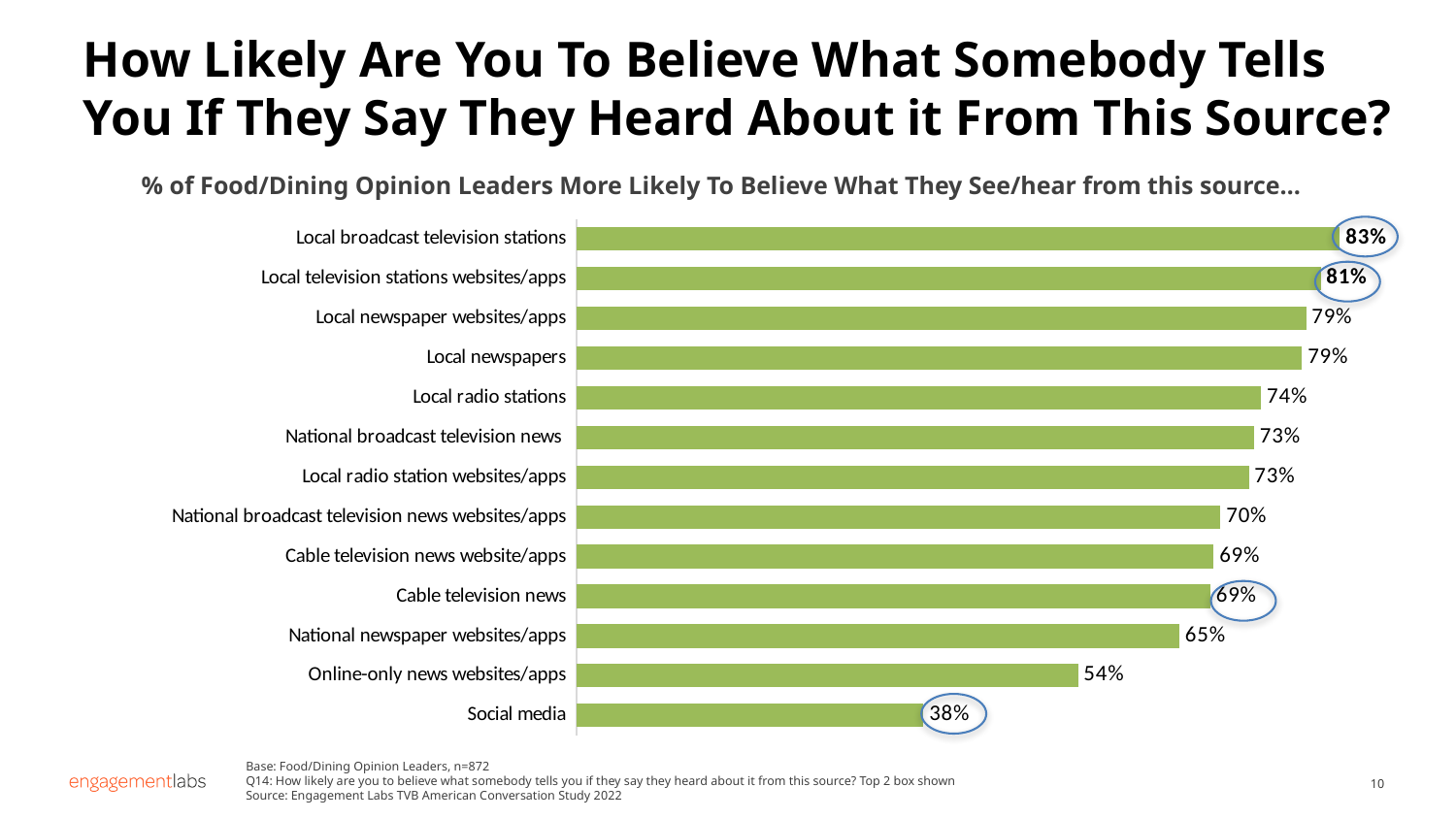
What is the value shown for Social media? 38% What colour are the bars on the chart? Green What kind of chart is shown on the slide? Bar chart Which has a larger value: Local newspapers or Cable television news? Local newspapers Which source has the highest percentage on the chart? Local broadcast television stations What is the difference between the values for Local broadcast television stations and Social media? 45 percentage points What is the value shown for Online-only news websites/apps? 54% What is the value shown for Local radio stations? 74% How many sources are shown on the chart? 13 Which source has the lowest percentage on the chart? Social media What is the difference between the values for Local television stations websites/apps and National newspaper websites/apps? 16 percentage points What percentage of Food/Dining Opinion Leaders are more likely to believe what they hear from local broadcast television stations? 83%